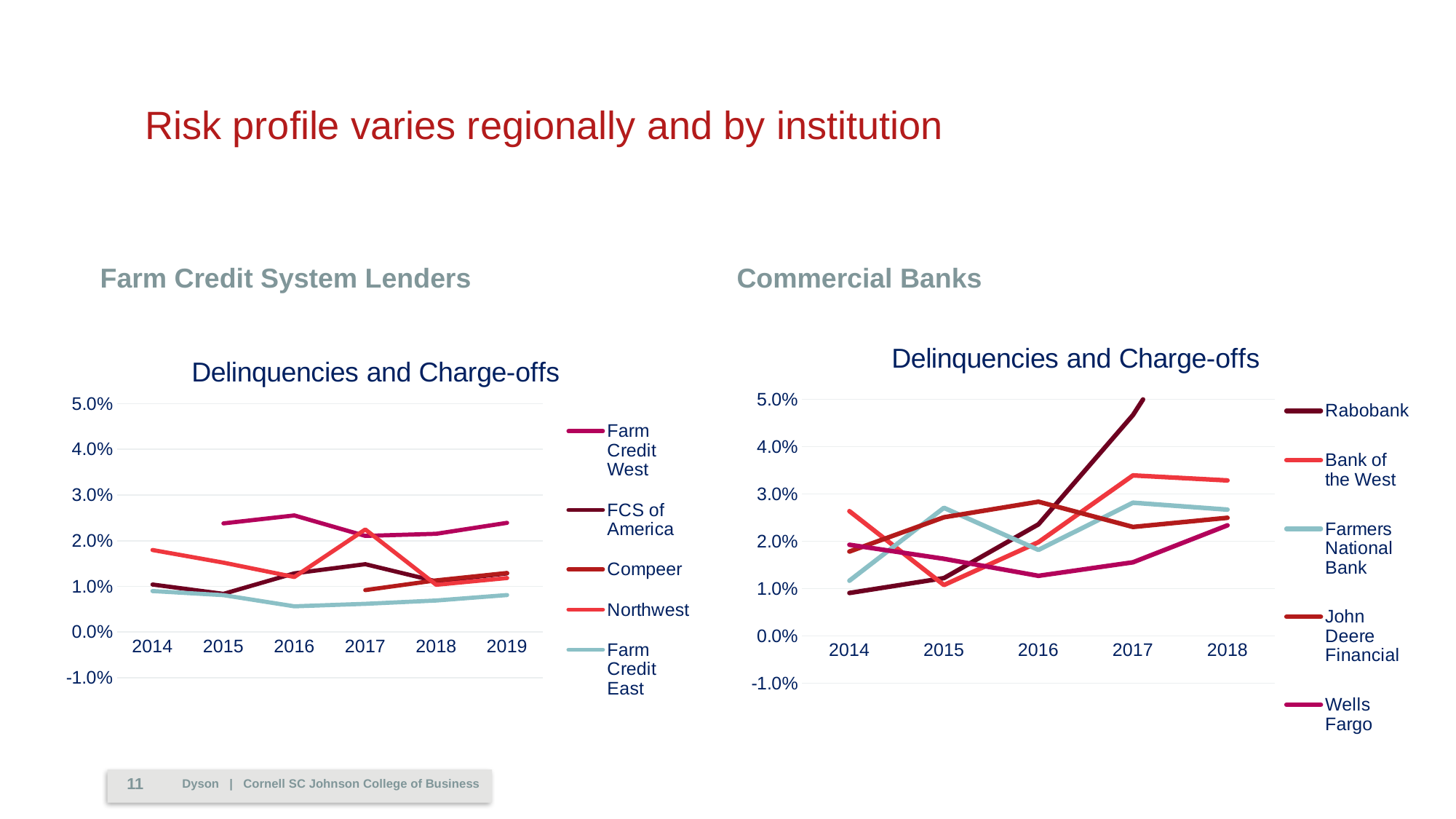
What is the title of the Commercial Banks chart? Delinquencies and Charge-offs What kind of chart is the Farm Credit System Lenders chart on the left? line chart How many series does the legend of the Commercial Banks chart list? 5 In the Farm Credit System Lenders chart, is the value for Farm Credit East in 2016 greater or less than 1.0%? less How many years are shown on the x axis of the Commercial Banks chart? 5 In the Farm Credit System Lenders chart, which lender has the highest value in 2019? Farm Credit West In the Commercial Banks chart, does the Rabobank line rise or fall from 2014 to 2017? rise In the Commercial Banks chart, which bank has the highest value in 2017? Rabobank In the Farm Credit System Lenders chart, which is larger in 2018: Farm Credit West or Farm Credit East? Farm Credit West In the Commercial Banks chart, is the value for Bank of the West in 2017 greater or less than 3.0%? greater In the Farm Credit System Lenders chart, which lender has the lowest value in 2016? Farm Credit East How many years are shown on the x axis of the Farm Credit System Lenders chart? 6